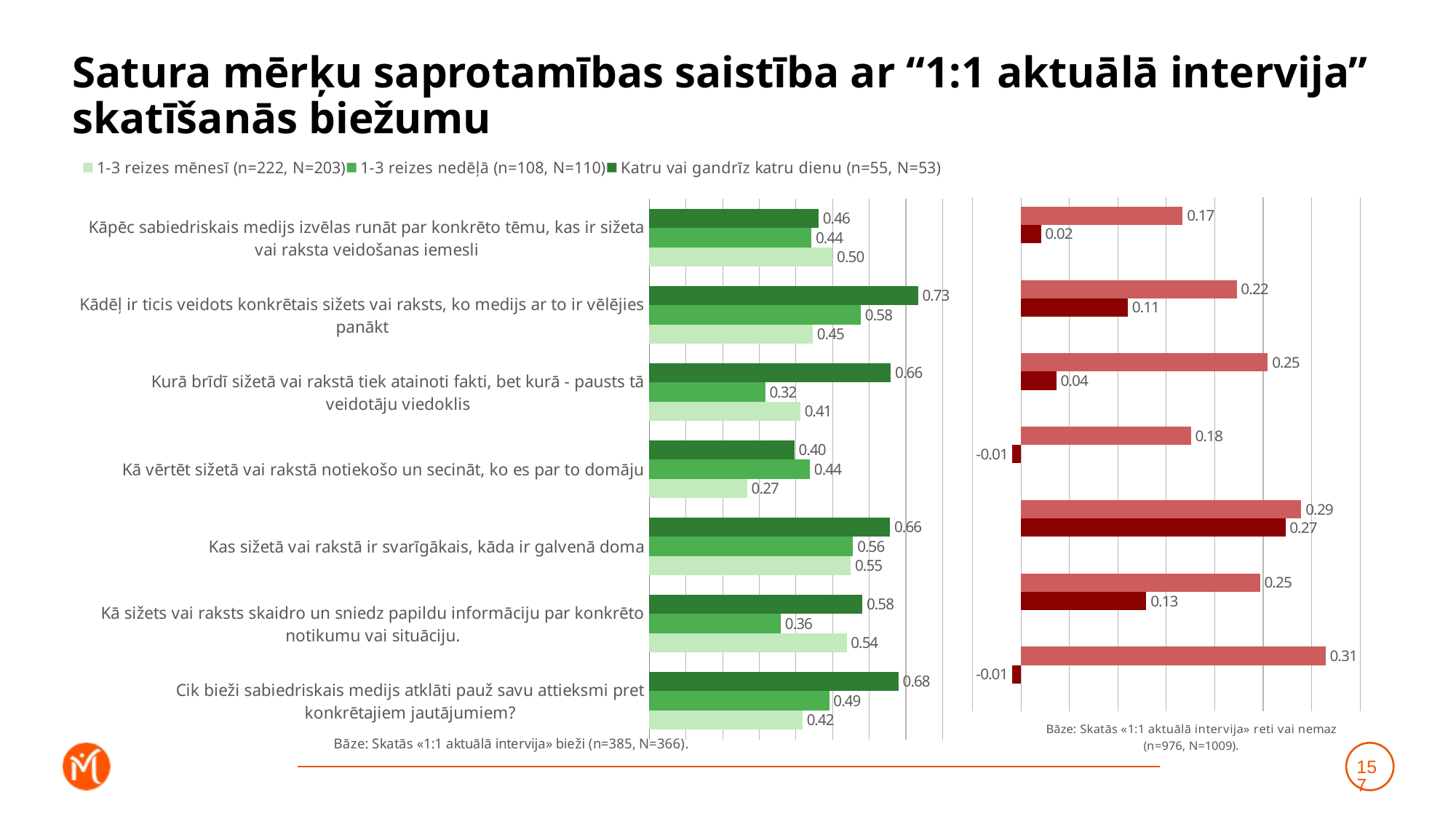
How many categories (statements) are shown in the green chart on the left? 7 What kind of chart is the green chart on the left of the slide? bar chart In the green chart on the left, what is the value for "Katru vai gandrīz katru dienu" for the statement "Kādēļ ir ticis veidots konkrētais sižets vai raksts, ko medijs ar to ir vēlējies panākt"? 0.73 In the green chart on the left, what is the value for "1-3 reizes mēnesī" for the statement "Kā sižets vai raksts skaidro un sniedz papildu informāciju par konkrēto notikumu vai situāciju."? 0.54 In the red chart on the right of the slide, what is the largest value shown? 0.31 What base note is printed below the green chart on the left? Bāze: Skatās «1:1 aktuālā intervija» bieži (n=385, N=366). In the green chart on the left, for the statement "Kādēļ ir ticis veidots konkrētais sižets vai raksts, ko medijs ar to ir vēlējies panākt", what is the difference between the "Katru vai gandrīz katru dienu" value and the "1-3 reizes mēnesī" value? 0.28 In the green chart on the left, which statement has the lowest value for "1-3 reizes mēnesī"? Kā vērtēt sižetā vai rakstā notiekošo un secināt, ko es par to domāju In the green chart on the left, which statement has the highest value for "Katru vai gandrīz katru dienu"? Kādēļ ir ticis veidots konkrētais sižets vai raksts, ko medijs ar to ir vēlējies panākt How many series does the legend at the top of the slide list? 3 In the green chart on the left, for the statement "Kā vērtēt sižetā vai rakstā notiekošo un secināt, ko es par to domāju", which is larger: the "1-3 reizes nedēļā" value or the "Katru vai gandrīz katru dienu" value? 1-3 reizes nedēļā In the green chart on the left, what is the value for "1-3 reizes nedēļā" for the statement "Kurā brīdī sižetā vai rakstā tiek atainoti fakti, bet kurā - pausts tā veidotāju viedoklis"? 0.32